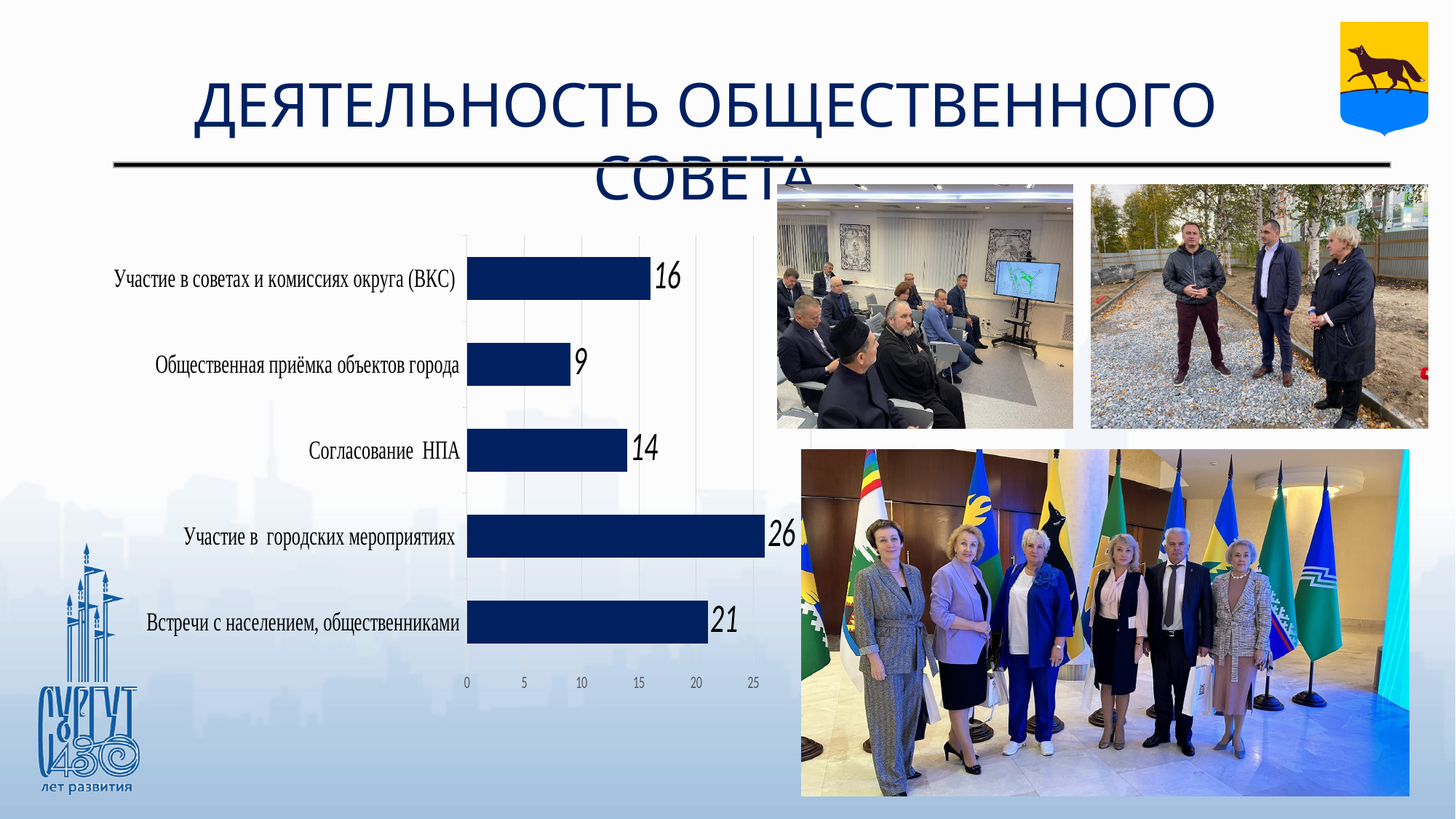
What is the value for "Общественная приёмка объектов города"? 9 What is the value for "Согласование НПА"? 14 Which category has the lowest value? Общественная приёмка объектов города What is the value for "Участие в советах и комиссиях округа (ВКС)"? 16 What is the difference between the values for "Участие в городских мероприятиях" and "Встречи с населением, общественниками"? 5 Which is larger: the value for "Участие в советах и комиссиях округа (ВКС)" or the value for "Согласование НПА"? Участие в советах и комиссиях округа (ВКС) What is the value for "Встречи с населением, общественниками"? 21 What is the value for "Участие в городских мероприятиях"? 26 Which category has the highest value? Участие в городских мероприятиях What kind of chart is shown on the slide? Bar chart How many categories does the chart show? 5 What is the title of the slide? ДЕЯТЕЛЬНОСТЬ ОБЩЕСТВЕННОГО СОВЕТА